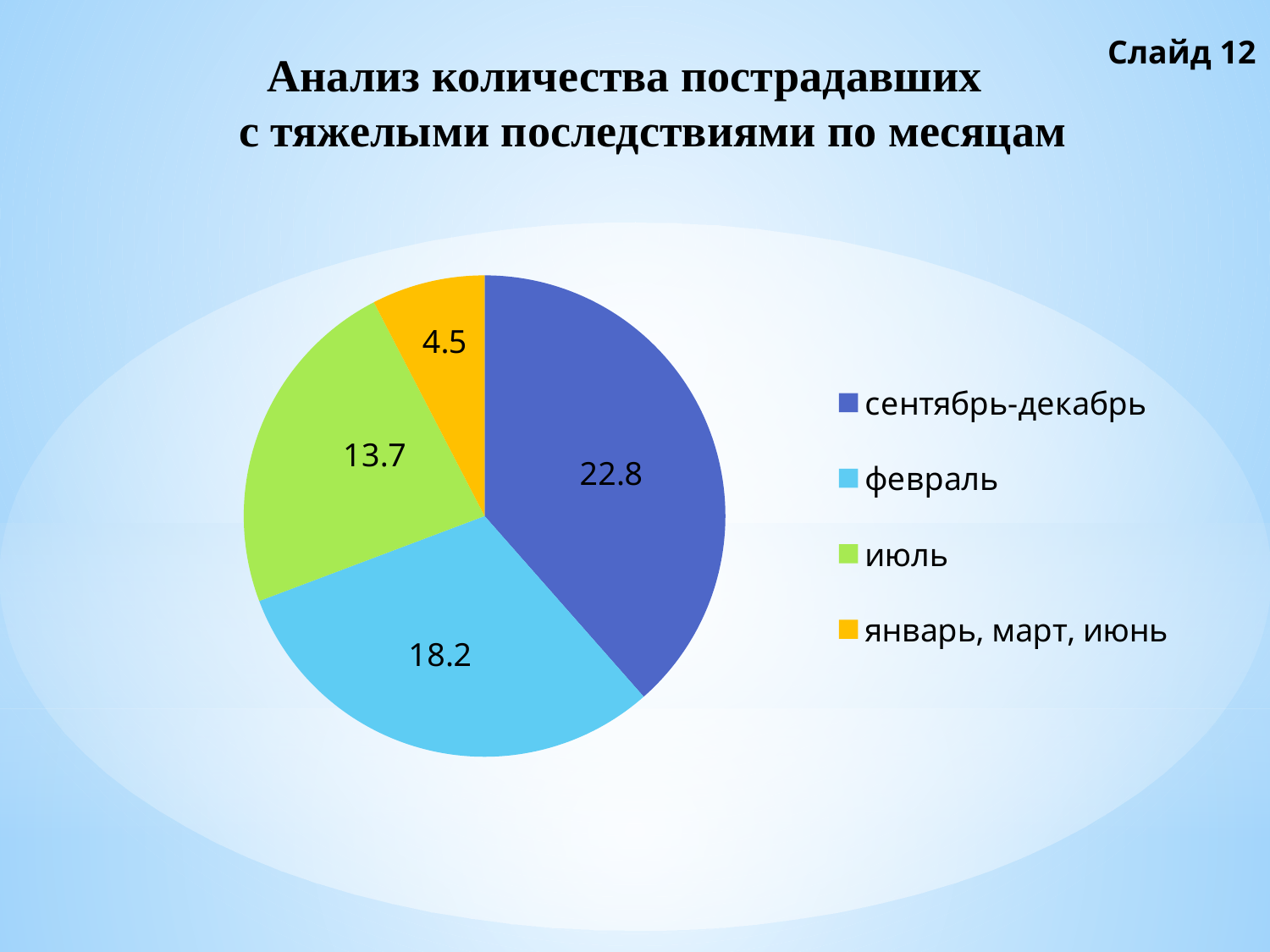
What is the value for июль? 13.7 What is the difference between the values for сентябрь-декабрь and февраль? 4.6 What colour is the slice for июль? green Which category has the largest slice? сентябрь-декабрь Which is larger, the value for февраль or the value for июль? февраль What is the difference between the values for июль and январь, март, июнь? 9.2 What is the value for февраль? 18.2 What type of chart is shown on the slide? pie chart Which category has the smallest slice? январь, март, июнь What is the value for январь, март, июнь? 4.5 How many categories does the pie chart have? 4 What is the value for сентябрь-декабрь? 22.8